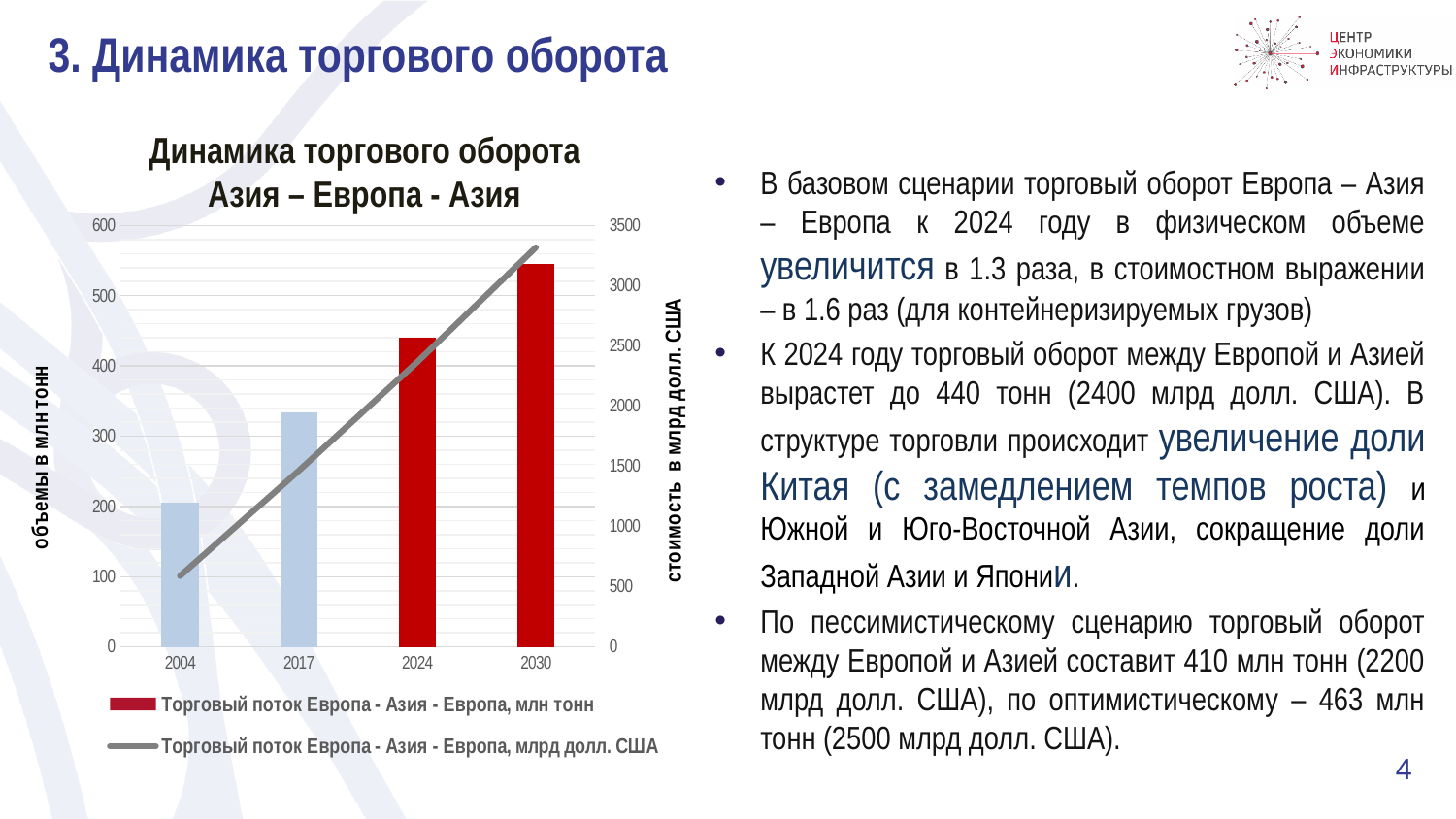
Is the bar value for 2004 (million tonnes) greater or less than 300? less Do the bar values rise or fall from 2004 to 2030? Rise What kind of chart is shown on the slide? A combined bar and line chart Which year has the shortest bar for trade flow in million tonnes? 2004 How many years are shown on the x axis of the chart? 4 Is the line value for 2030 (billion USD, right axis) greater or less than 3000? greater Which bar is taller, 2024 or 2017? 2024 Which year has the tallest bar for trade flow in million tonnes? 2030 Is the bar value for 2017 (million tonnes) greater or less than 300? greater What is the title of the chart? Динамика торгового оборота Азия – Европа - Азия How many series does the chart legend list? 2